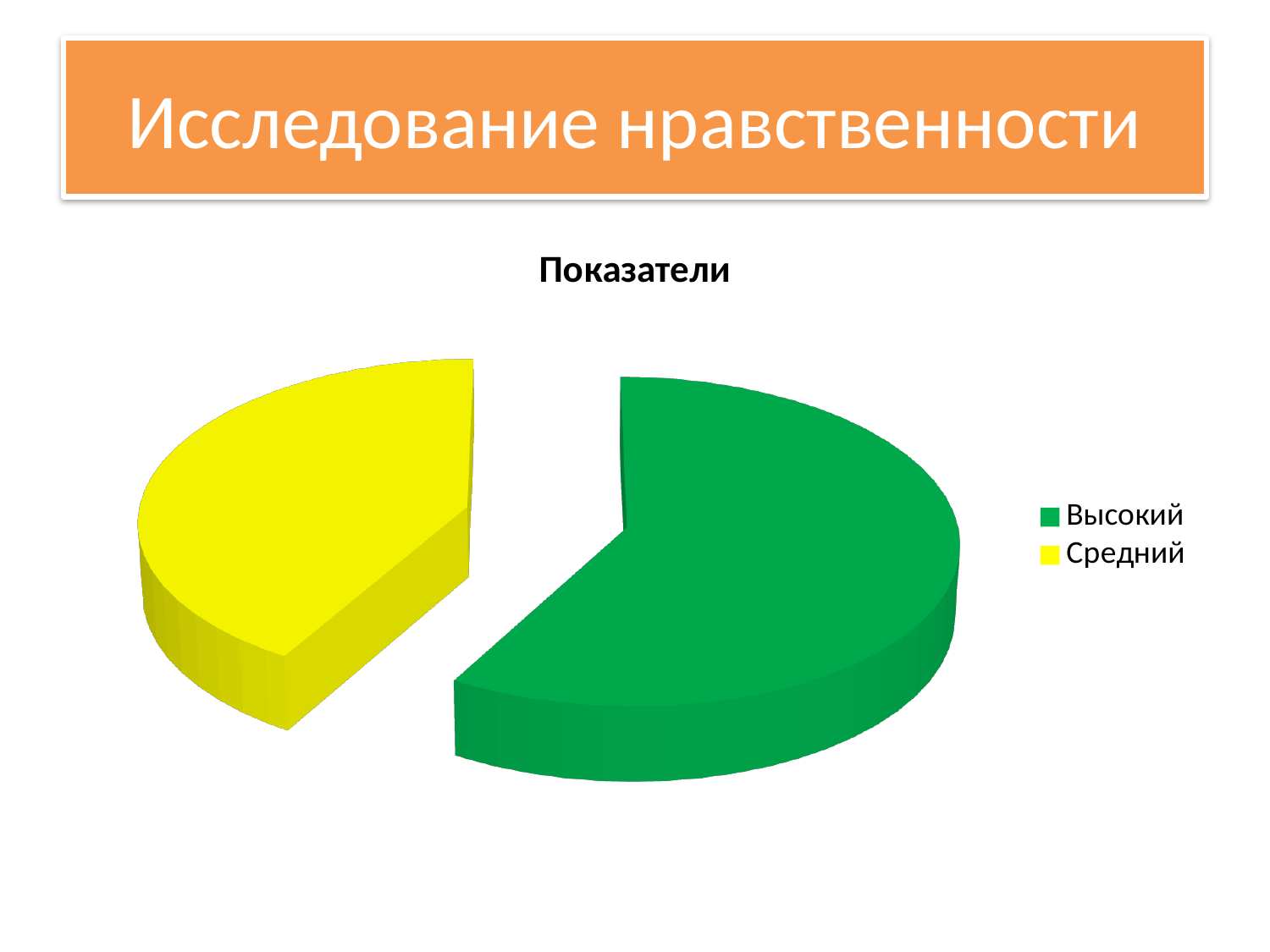
What kind of chart is shown on the slide? pie chart What colour is the slice for Средний? yellow Which slice is larger, Высокий or Средний? Высокий Which category has the largest slice in the pie chart? Высокий How many slices does the pie chart have? 2 How many categories does the legend of the chart list? 2 What is the title of the chart? Показатели Which category has the smallest slice in the pie chart? Средний